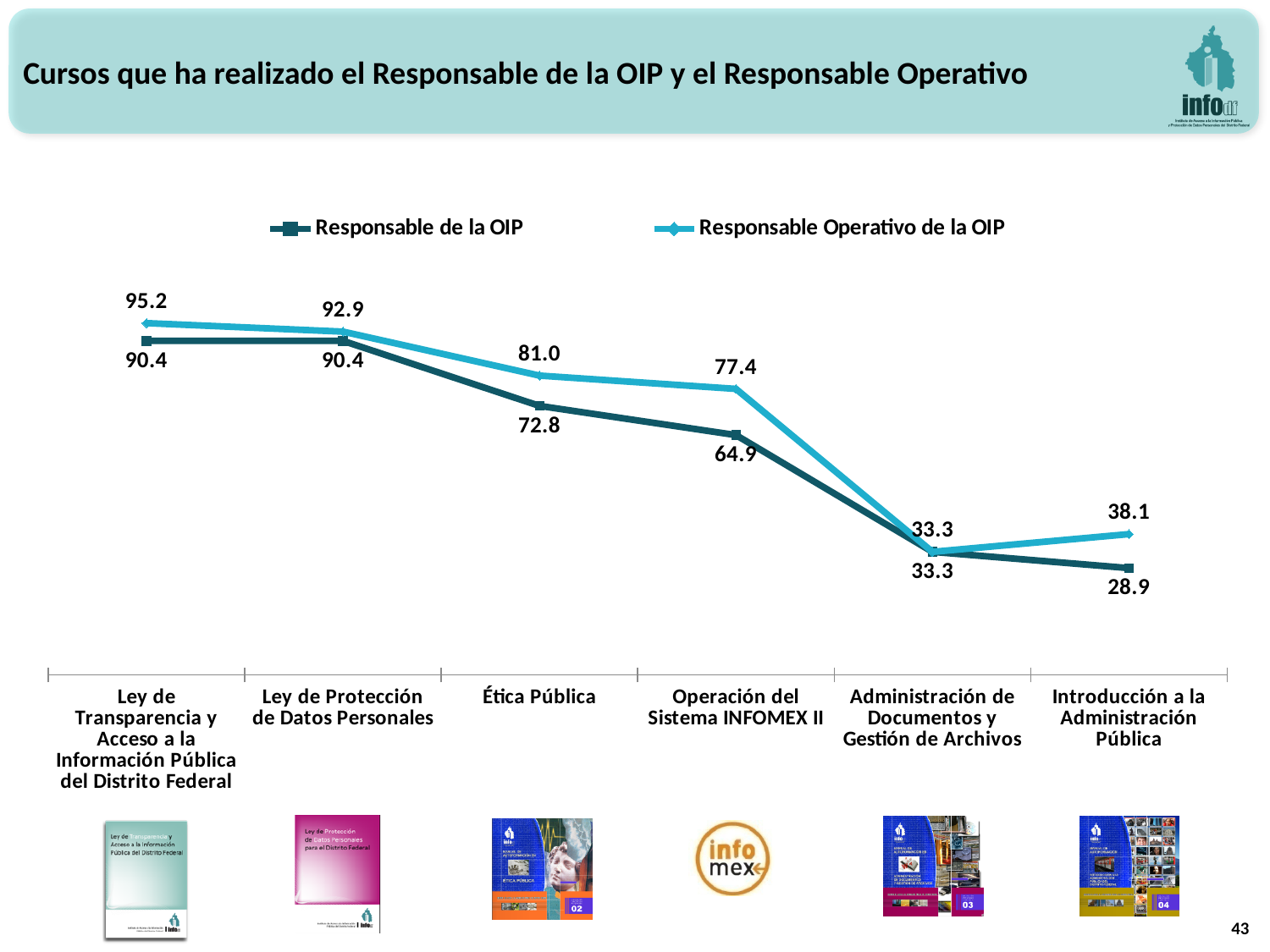
What type of chart is shown on the slide? Line chart Which course has the lowest value for Responsable de la OIP? Introducción a la Administración Pública For Ética Pública, which series has the larger value, Responsable de la OIP or Responsable Operativo de la OIP? Responsable Operativo de la OIP Which course has the highest value for Responsable Operativo de la OIP? Ley de Transparencia y Acceso a la Información Pública del Distrito Federal What is the value for Responsable Operativo de la OIP for Introducción a la Administración Pública? 38.1 What is the value for Responsable de la OIP for Ética Pública? 72.8 How many course categories are plotted along the x axis? 6 What is the value for Responsable Operativo de la OIP for Ley de Transparencia y Acceso a la Información Pública del Distrito Federal? 95.2 What is the difference between Responsable Operativo de la OIP and Responsable de la OIP for Operación del Sistema INFOMEX II? 12.5 How many series does the legend list? 2 Do the values for Responsable de la OIP generally rise or fall from left to right along the x axis? Fall What is the value for Responsable de la OIP for Operación del Sistema INFOMEX II? 64.9